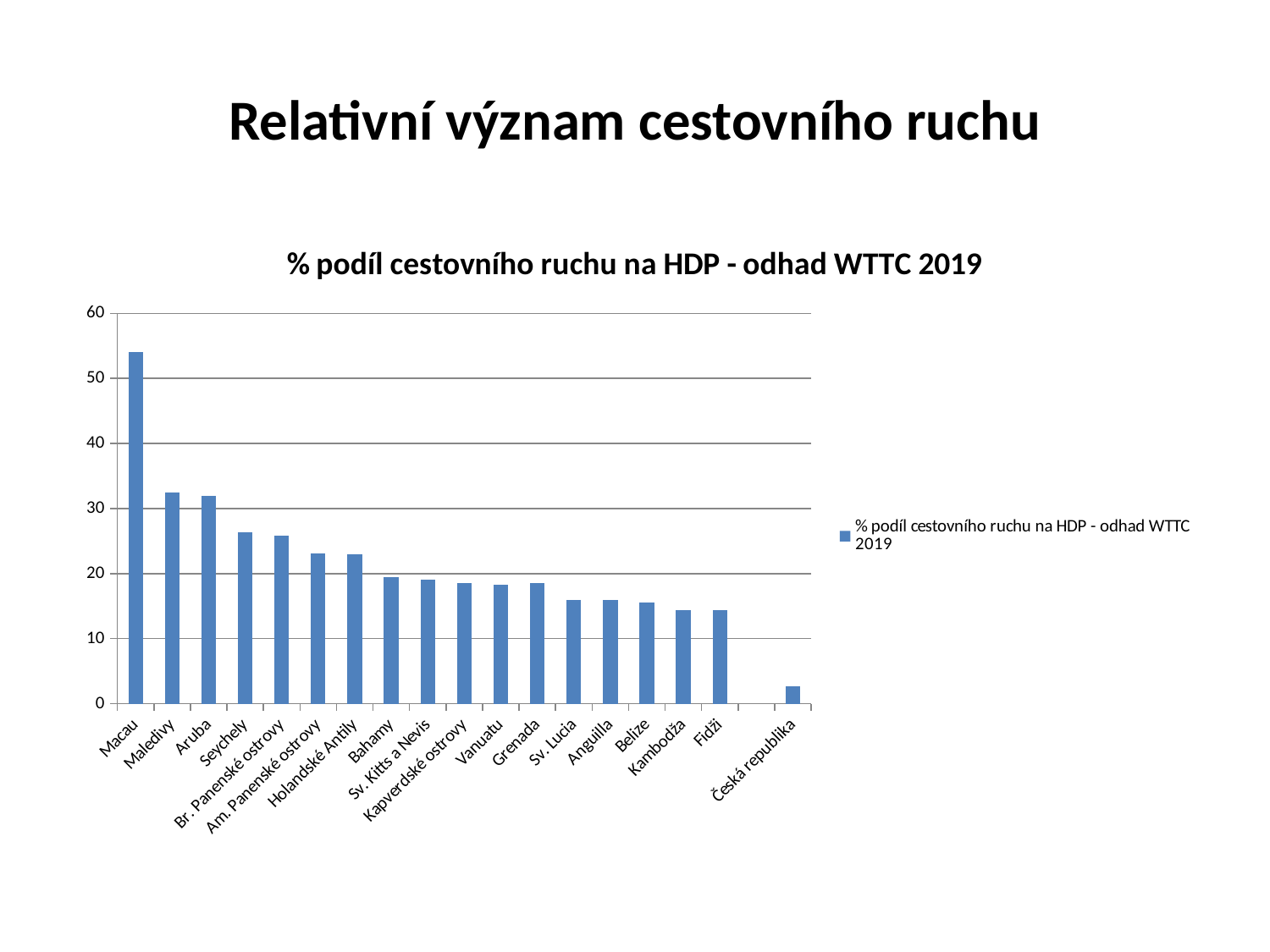
Which category has the lowest value? Česká republika Is the value for Macau greater or less than 50? greater Is the value for Seychely greater or less than 30? less Which is larger, the value for Macau or the value for Maledivy? Macau What is the title of the chart? % podíl cestovního ruchu na HDP - odhad WTTC 2019 What kind of chart is shown on the slide? bar chart Which is larger, the value for Seychely or the value for Bahamy? Seychely Do the values generally rise or fall from left to right along the x axis? fall Is the value for Česká republika greater or less than 10? less Which category has the highest value? Macau How many series does the legend list? 1